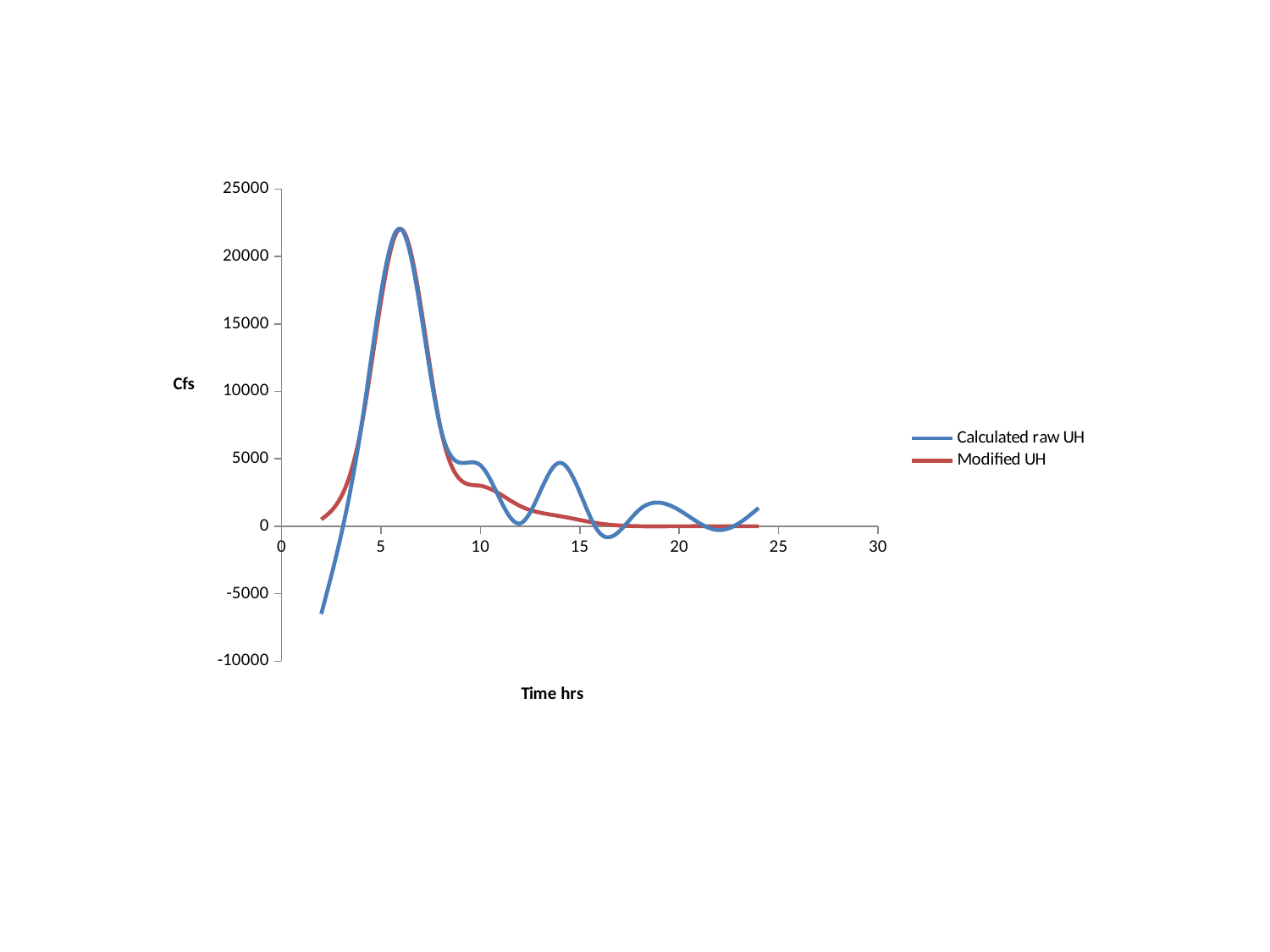
At 2 hours, which series has the higher value, Calculated raw UH or Modified UH? Modified UH How many series does the legend list? 2 Is the peak value of the Calculated raw UH series greater or less than 20000? greater Does the Modified UH series rise or fall between 6 hours and 24 hours? fall Does the Modified UH series rise or fall between 2 hours and 6 hours? rise Is the value of the Calculated raw UH series at 2 hours greater or less than 0? less What kind of chart is shown on the slide? line chart Is the value of the Modified UH series at 2 hours greater or less than 5000? less At 14 hours, which series has the higher value, Calculated raw UH or Modified UH? Calculated raw UH What is the label on the horizontal axis? Time hrs What are the two series named in the legend? Calculated raw UH and Modified UH